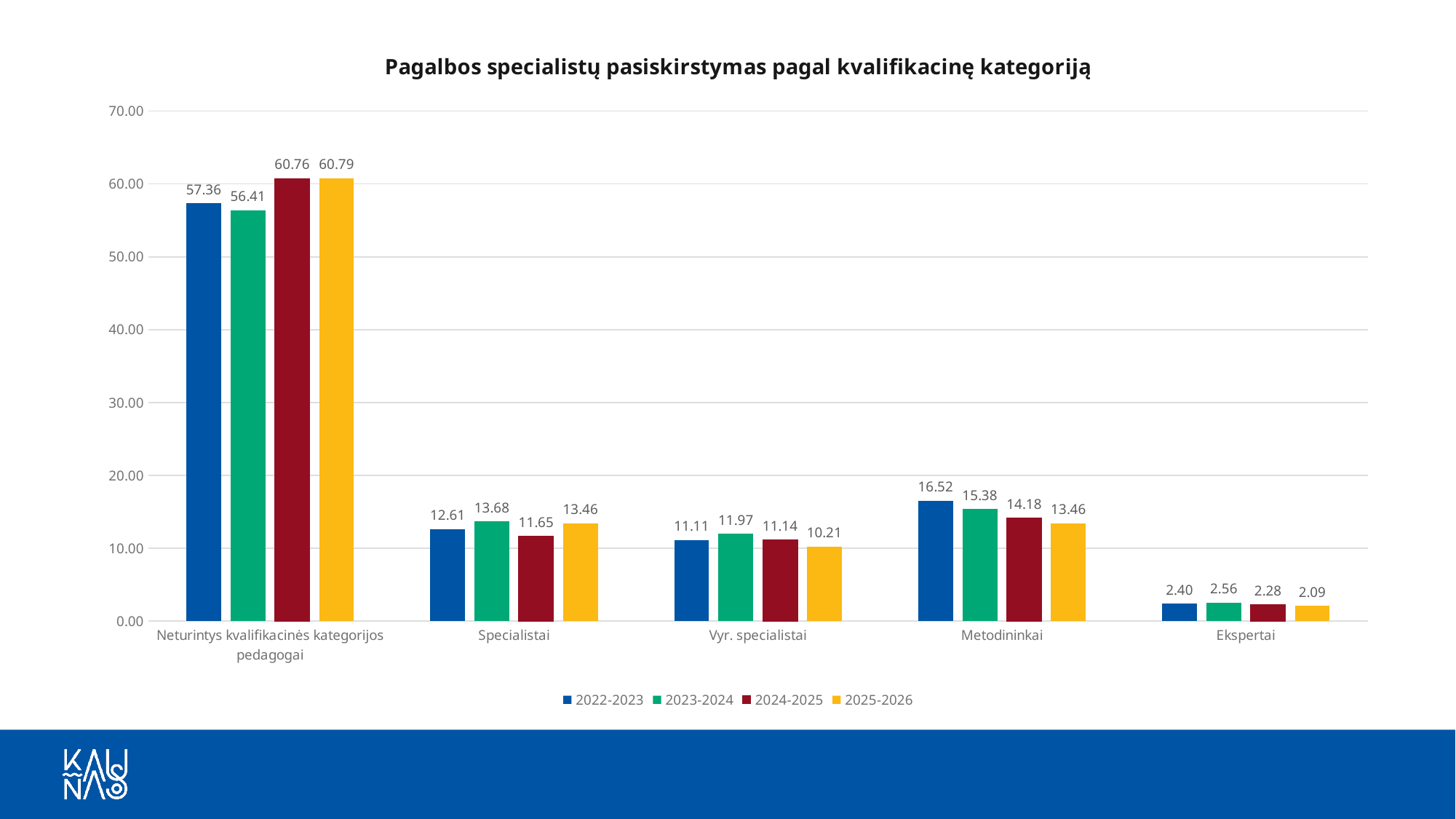
What is the title of the chart? Pagalbos specialistų pasiskirstymas pagal kvalifikacinę kategoriją Which is larger for Vyr. specialistai: the 2023-2024 value or the 2025-2026 value? 2023-2024 How many series does the legend list? 4 How many categories are shown on the x axis? 5 What is the value for Specialistai in the 2024-2025 series? 11.65 What is the value for Ekspertai in the 2025-2026 series? 2.09 Is the value for Neturintys kvalifikacinės kategorijos pedagogai in 2022-2023 greater or less than 50.00? greater What kind of chart is shown on the slide? bar chart What is the value for Metodininkai in the 2022-2023 series? 16.52 Which category has the lowest value in the 2023-2024 series? Ekspertai Which category has the highest value in the 2025-2026 series? Neturintys kvalifikacinės kategorijos pedagogai What is the difference between the 2022-2023 and 2025-2026 values for Metodininkai? 3.06